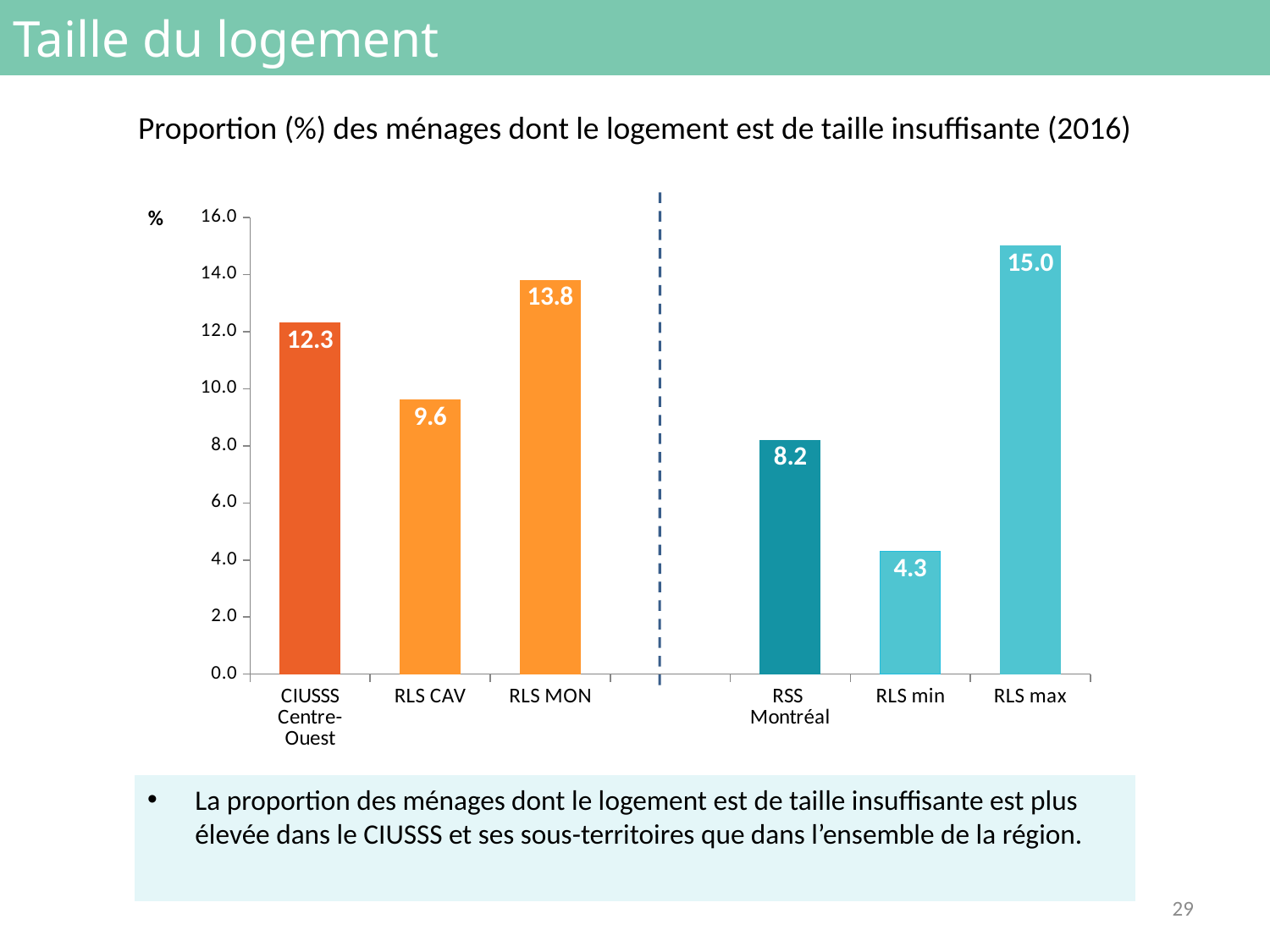
What is the value for RLS min? 4.3 What kind of chart is shown on the slide? Bar chart What is the value for RSS Montréal? 8.2 Which category has the highest value? RLS max Which is larger, the value for RLS MON or the value for CIUSSS Centre-Ouest? RLS MON What is the difference between the values for RLS MON and RLS CAV? 4.2 How many categories are shown on the x axis? 6 What is the value for RLS CAV? 9.6 Which category has the lowest value? RLS min What is the difference between the values for CIUSSS Centre-Ouest and RSS Montréal? 4.1 What is the title of the chart? Proportion (%) des ménages dont le logement est de taille insuffisante (2016) What is the value for CIUSSS Centre-Ouest? 12.3